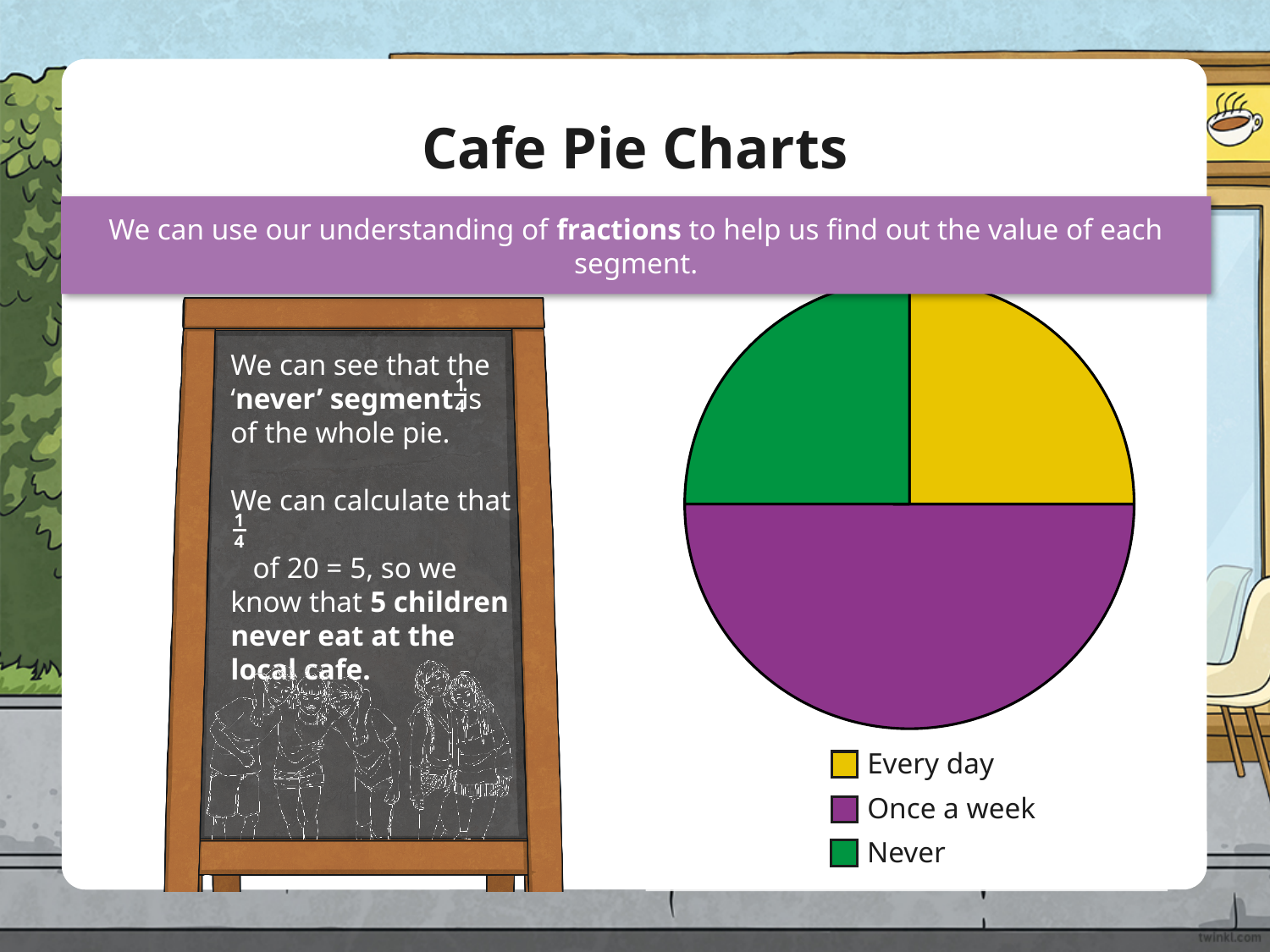
Which legend entry is shown in yellow? Every day According to the slide, how many children in total does the pie chart represent? 20 Which is larger in the pie chart, the 'Once a week' segment or the 'Never' segment? Once a week How many segments does the pie chart have? 3 Which segment of the pie chart is the largest? Once a week According to the slide, how many children never eat at the local cafe? 5 children What fraction of the whole pie is the 'Never' segment? 1/4 Which is larger in the pie chart, the 'Once a week' segment or the 'Every day' segment? Once a week What colour is the 'Never' segment in the pie chart? green What kind of chart is shown on the slide? pie chart How many entries does the legend of the pie chart list? 3